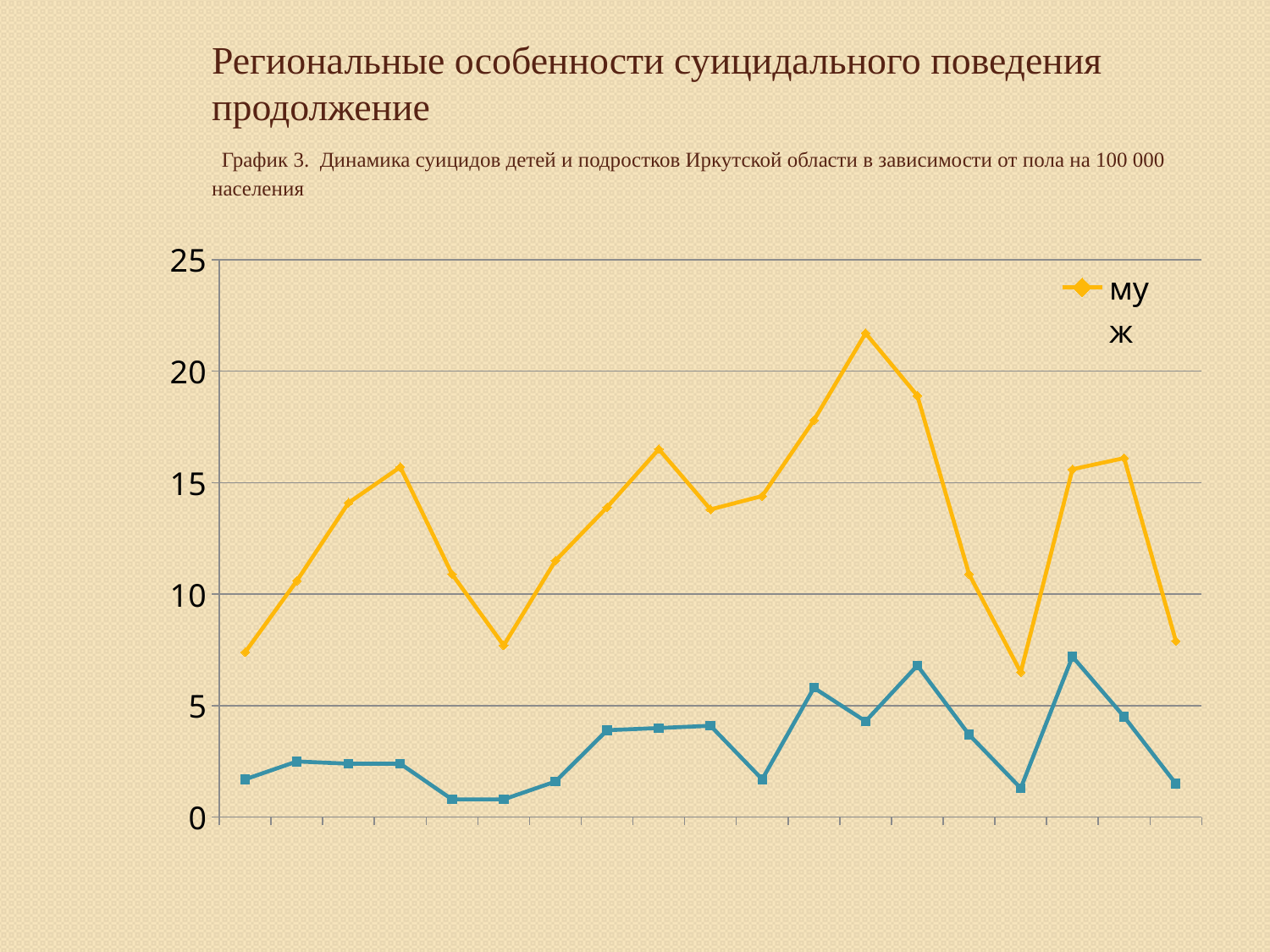
Which series has the higher values throughout the chart, "му" or "ж"? му Is the lowest value of the "ж" series greater or less than 5? less Is the highest value of the "ж" series greater or less than 10? less Is the first value of the "му" series greater or less than 10? less How many series does the legend list? 2 Which colour is used for the series "му"? orange What are the two series named in the legend? му and ж What is the maximum value shown on the vertical axis? 25 How many data points does the "му" line have? 19 What kind of chart is shown on the slide? line chart